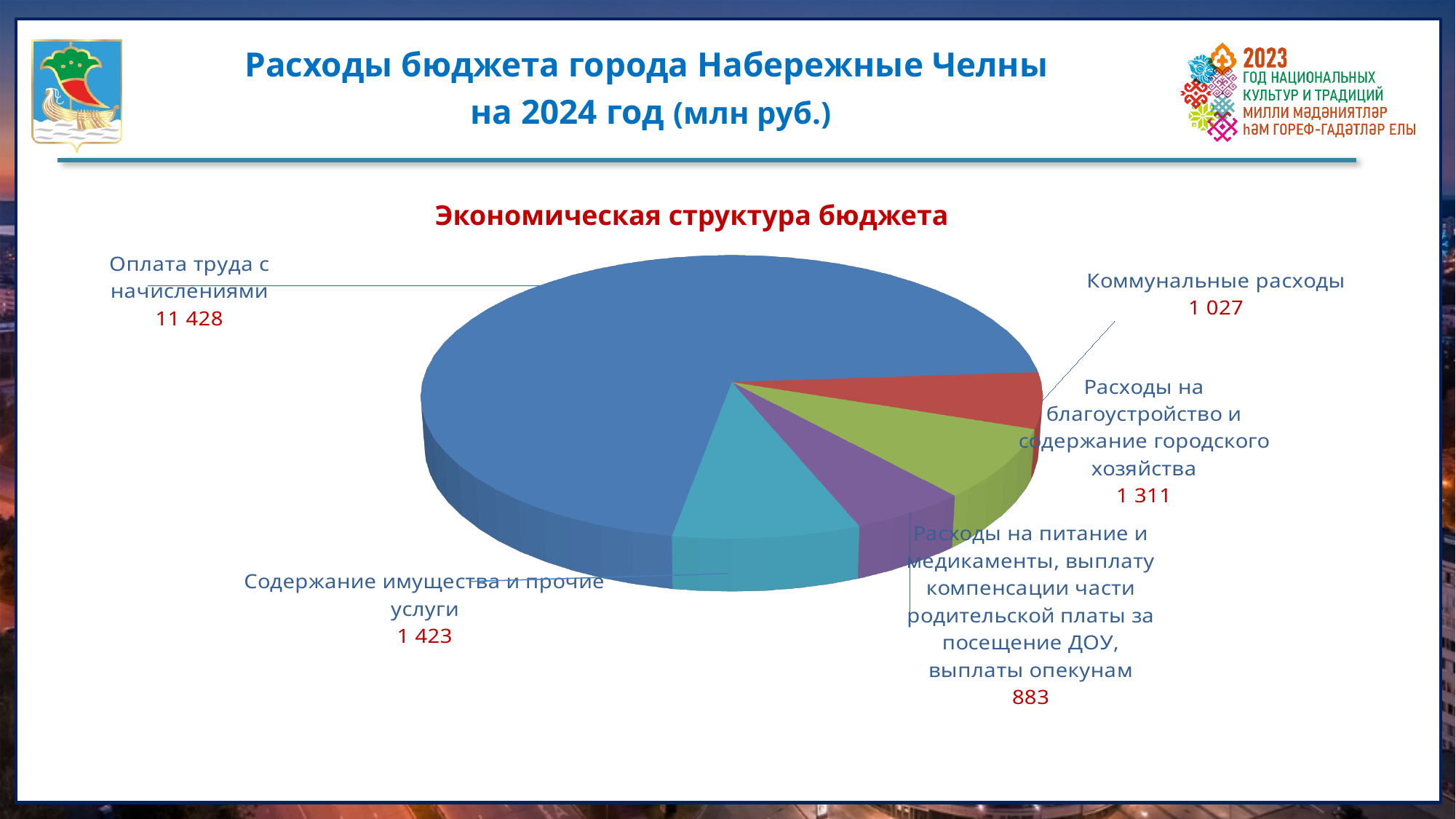
What is the value for Содержание имущества и прочие услуги? 1 423 How many categories does the pie chart show? 5 What is the value for Коммунальные расходы? 1 027 What is the difference between Оплата труда с начислениями and Содержание имущества и прочие услуги? 10 005 What is the value for Оплата труда с начислениями? 11 428 What is the title of the chart on the slide? Экономическая структура бюджета What type of chart is shown on the slide? Pie chart What is the value for Расходы на благоустройство и содержание городского хозяйства? 1 311 What is the difference between Коммунальные расходы and Расходы на питание и медикаменты, выплату компенсации части родительской платы за посещение ДОУ, выплаты опекунам? 144 Which category has the largest value in the pie chart? Оплата труда с начислениями Which category has the smallest value in the pie chart? Расходы на питание и медикаменты, выплату компенсации части родительской платы за посещение ДОУ, выплаты опекунам Which is larger: Содержание имущества и прочие услуги or Расходы на благоустройство и содержание городского хозяйства? Содержание имущества и прочие услуги